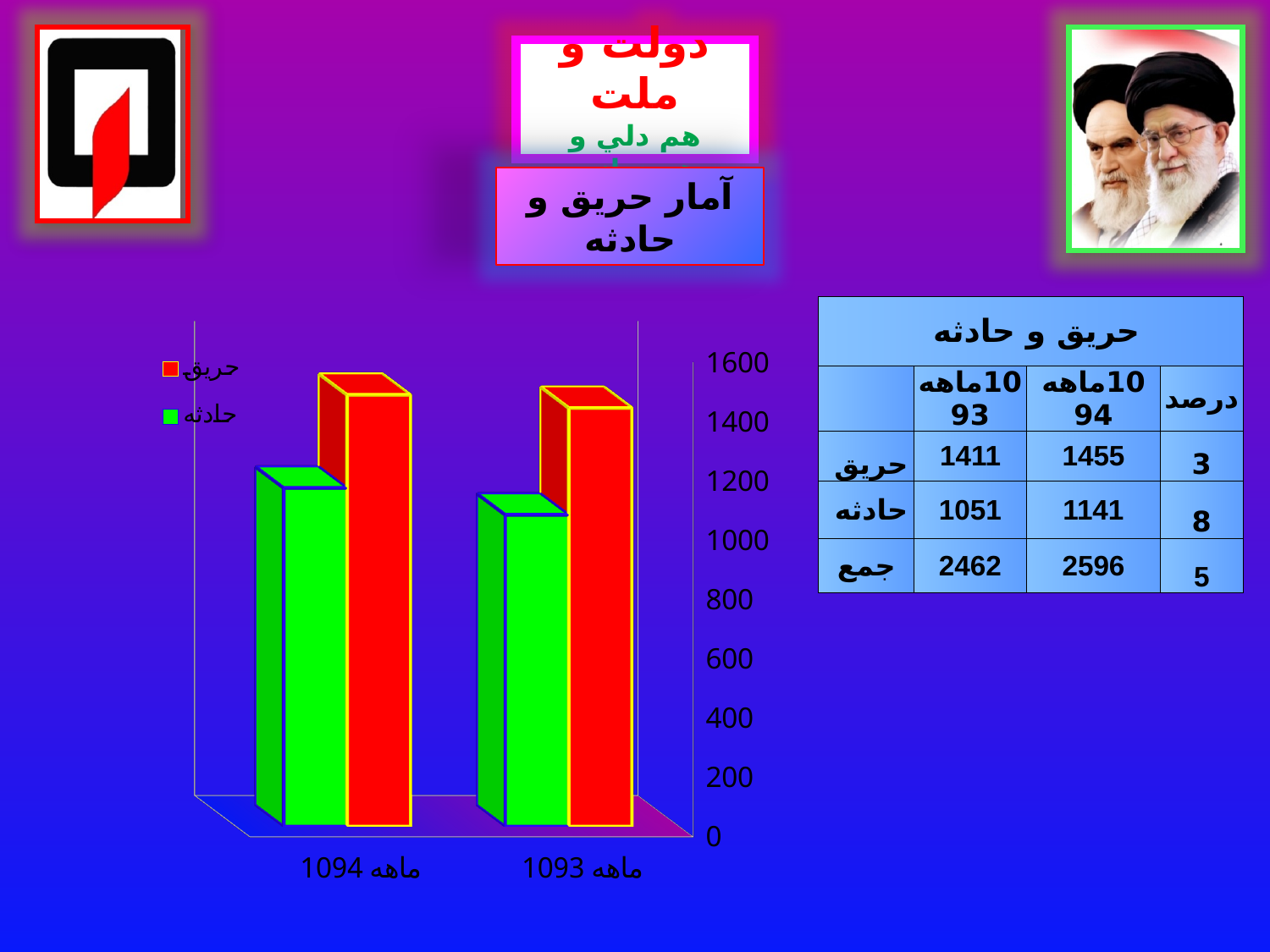
Is the value of the حریق bar for ماهه 1094 greater or less than 1400? greater What is the highest value shown on the chart's vertical axis? 1600 Is the value of the حادثه bar for ماهه 1094 greater or less than 1200? less Which series is drawn in green in the chart? حادثه How many categories are shown on the x axis of the chart? 2 Which series is drawn in red in the chart? حریق Is the value of the حریق bar for ماهه 1093 greater or less than 1200? greater What kind of chart is shown on the slide? bar chart How many series does the chart legend list? 2 In the chart, which series has the taller bar for ماهه 1094, حریق or حادثه? حریق In the chart, which series has the taller bar for ماهه 1093, حریق or حادثه? حریق